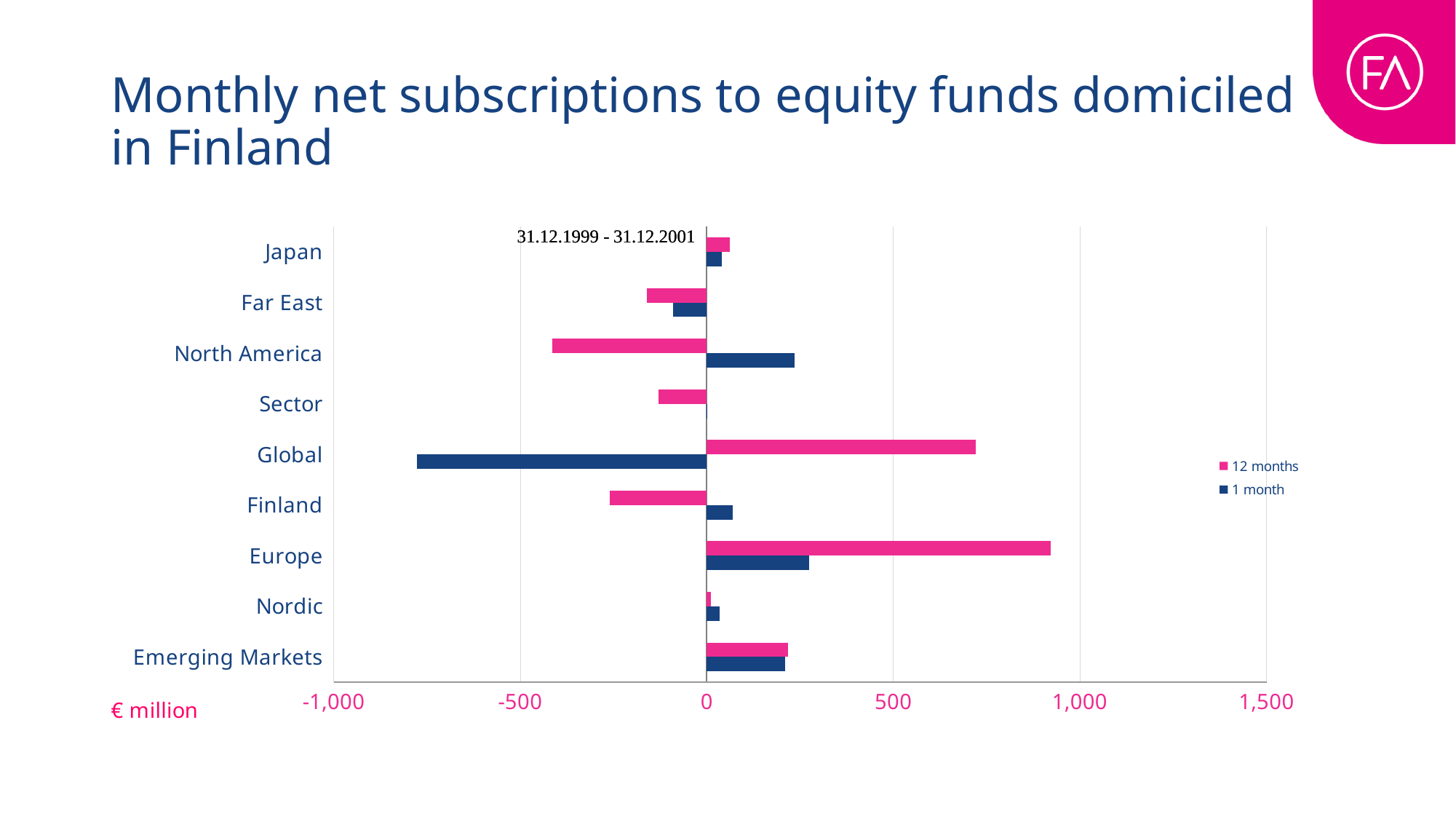
What kind of chart is shown on the slide? Bar chart Which is larger, the 12 months value for Europe or the 12 months value for Global? Europe Is the 12 months value for North America greater or less than -500? greater Which is larger, the 12 months value for Japan or the 12 months value for Nordic? Japan Which category has the lowest 12 months value? North America How many series does the legend list? 2 Is the 12 months value for Europe greater or less than 500? greater How many categories are shown on the vertical axis of the chart? 9 What unit is shown for the horizontal axis of the chart? € million Which category has the lowest 1 month value? Global Which category has the highest 12 months value? Europe Is the 1 month value for Global greater or less than -500? less